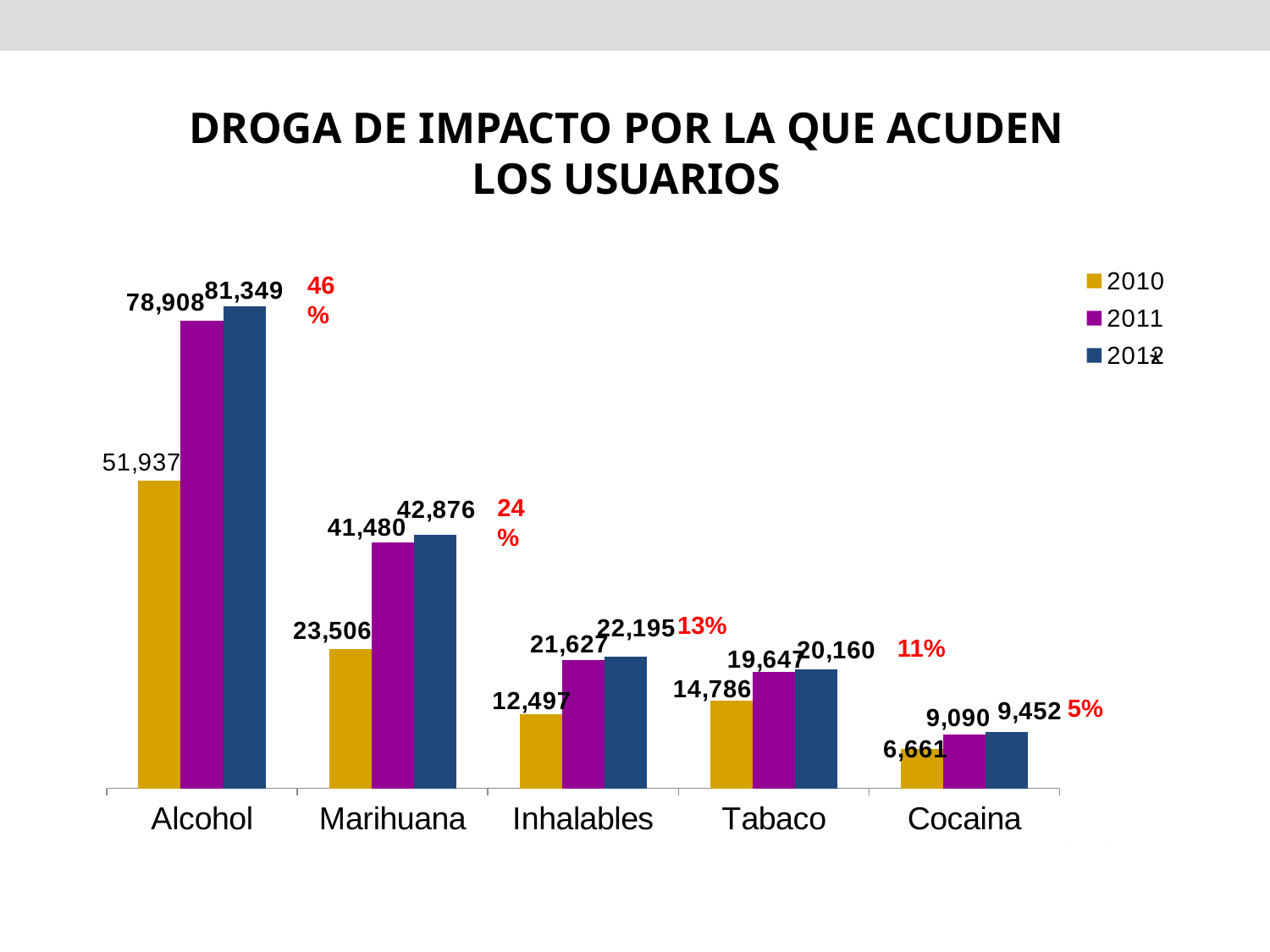
What is the difference between the 2012 and 2010 values for Alcohol? 29,412 How many series does the legend list? 3 What is the value for Inhalables in the 2011 series? 21,627 How many categories are shown on the x axis? 5 What is the value for Cocaina in the 2010 series? 6,661 What is the value for Marihuana in the 2012 series? 42,876 Which category has the lowest value in the 2011 series? Cocaina Which is larger: the 2010 value for Tabaco or the 2010 value for Inhalables? Tabaco (14,786) What is the value for Alcohol in the 2010 series? 51,937 What kind of chart is shown on the slide? Bar chart Which category has the highest value in the 2012 series? Alcohol What red percentage is shown next to the Marihuana bars? 24%